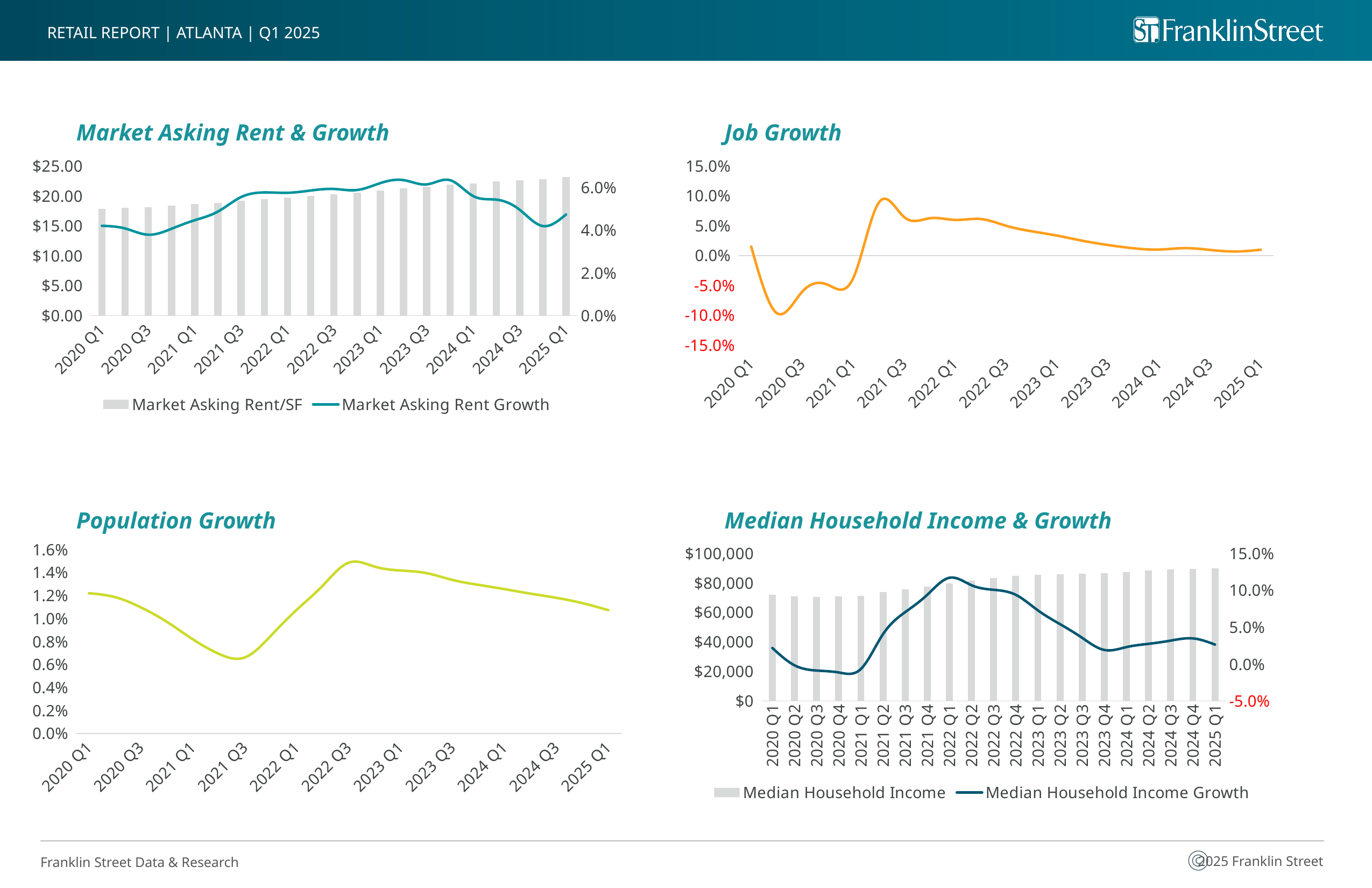
In the Median Household Income & Growth chart, is the Median Household Income for 2025 Q1 greater or less than $80,000? greater In the Population Growth chart, is the value for 2021 Q3 greater or less than 0.8%? less How many quarters are shown on the x axis of the Median Household Income & Growth chart? 21 In the Market Asking Rent & Growth chart, is the Market Asking Rent/SF for 2025 Q1 greater or less than $20.00? greater In the Job Growth chart, do values rise or fall from 2021 Q3 to 2025 Q1? fall In the Job Growth chart, which quarter has the lowest job growth? 2020 Q2 In the Population Growth chart, which is larger, the value for 2022 Q3 or the value for 2021 Q3? 2022 Q3 What kind of chart is the Market Asking Rent & Growth chart? Combined bar and line chart What kind of chart is the Job Growth chart? Line chart How many series does the legend of the Median Household Income & Growth chart list? 2